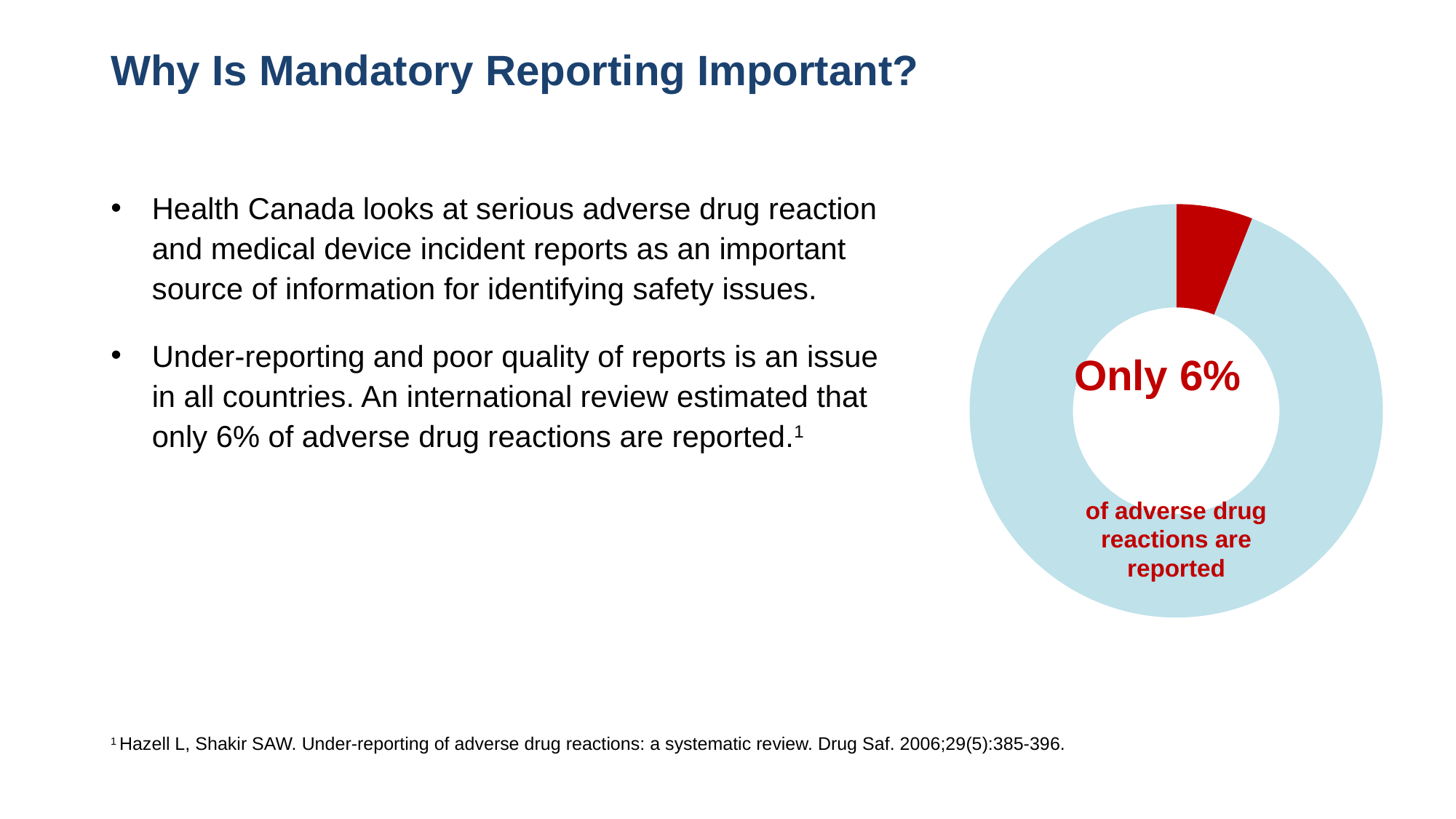
What share of the donut chart is taken up by the light blue slice? 94% Which slice of the donut chart is larger, the red slice or the light blue slice? the light blue slice How many slices does the donut chart have? 2 What share of adverse drug reactions does the red slice of the donut chart represent? 6% What kind of chart is shown on the slide? donut chart What percentage is printed in the centre of the donut chart? Only 6% What does the text inside the donut chart say the 6% refers to? of adverse drug reactions are reported Which slice of the donut chart is the smallest? the red slice What colour is the slice representing the 6% of adverse drug reactions that are reported? red